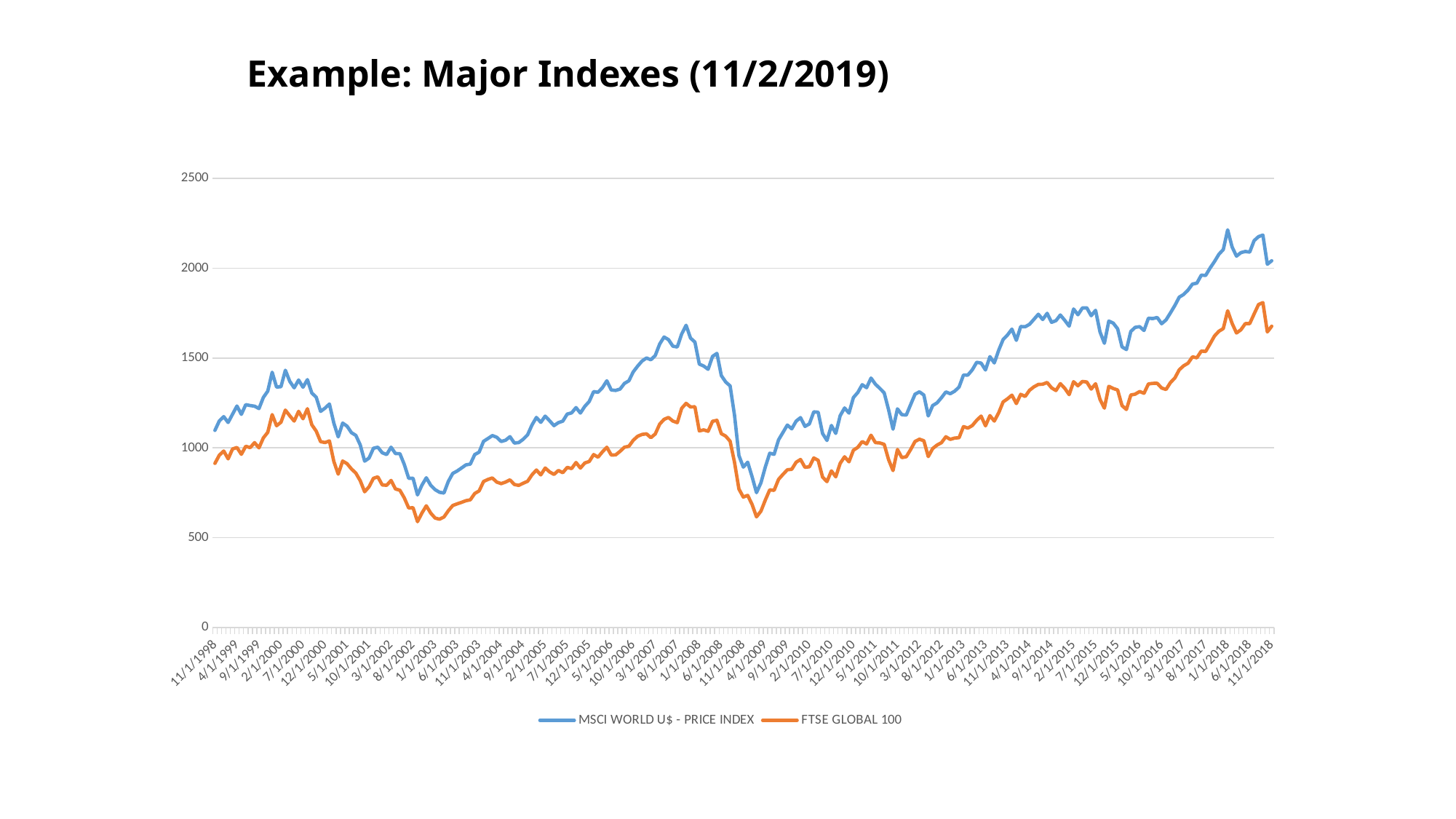
Is the value of MSCI WORLD U$ - PRICE INDEX at 1/1/2018 greater or less than 2000? greater Is the value of MSCI WORLD U$ - PRICE INDEX at 4/1/2009 greater or less than 1000? less Which series reaches the highest value anywhere on the chart? MSCI WORLD U$ - PRICE INDEX Is the value of FTSE GLOBAL 100 at 1/1/2018 greater or less than 2000? less At 11/1/2018, which series has the higher value, MSCI WORLD U$ - PRICE INDEX or FTSE GLOBAL 100? MSCI WORLD U$ - PRICE INDEX What is the title of the slide's chart? Example: Major Indexes (11/2/2019) How many series does the legend list? 2 What kind of chart is shown on the slide? line chart Between 8/1/2007 and 4/1/2009, does the MSCI WORLD U$ - PRICE INDEX line rise or fall? fall Which series is drawn in orange? FTSE GLOBAL 100